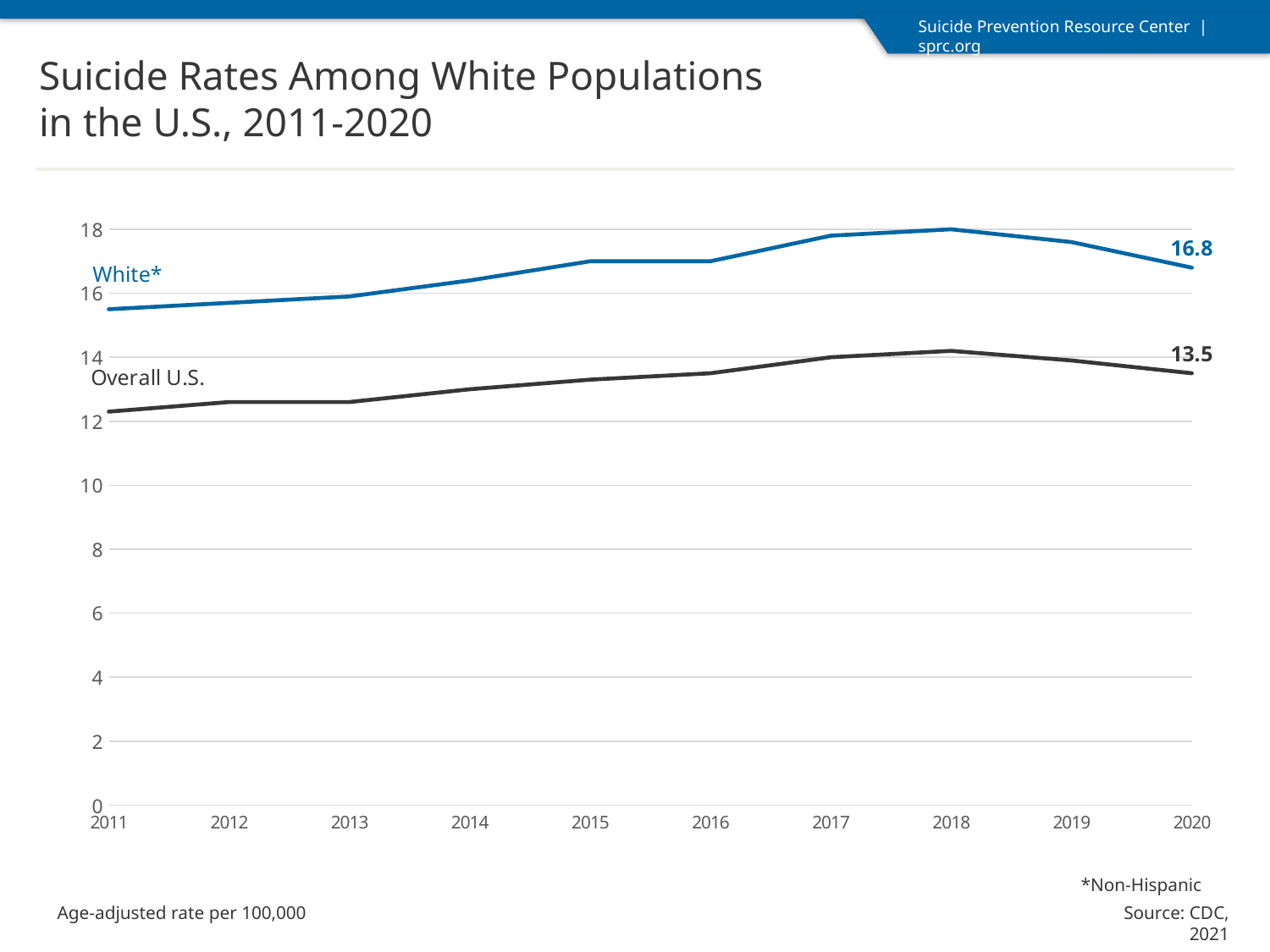
What is the difference between the White* and Overall U.S. values in 2020? 3.3 What is the value for Overall U.S. in 2020? 13.5 What is the value for White* in 2020? 16.8 How many series are plotted on the chart? 2 Does the White* series rise or fall from 2011 to 2018? rise Is the value for White* in 2011 greater or less than 16? less Is the value for Overall U.S. in 2011 greater or less than 14? less In 2020, which series has the higher value, White* or Overall U.S.? White* In which year does the White* series reach its highest value? 2018 In which year is the White* series at its lowest value? 2011 How many years are plotted along the x axis? 10 What kind of chart is shown on the slide? Line chart